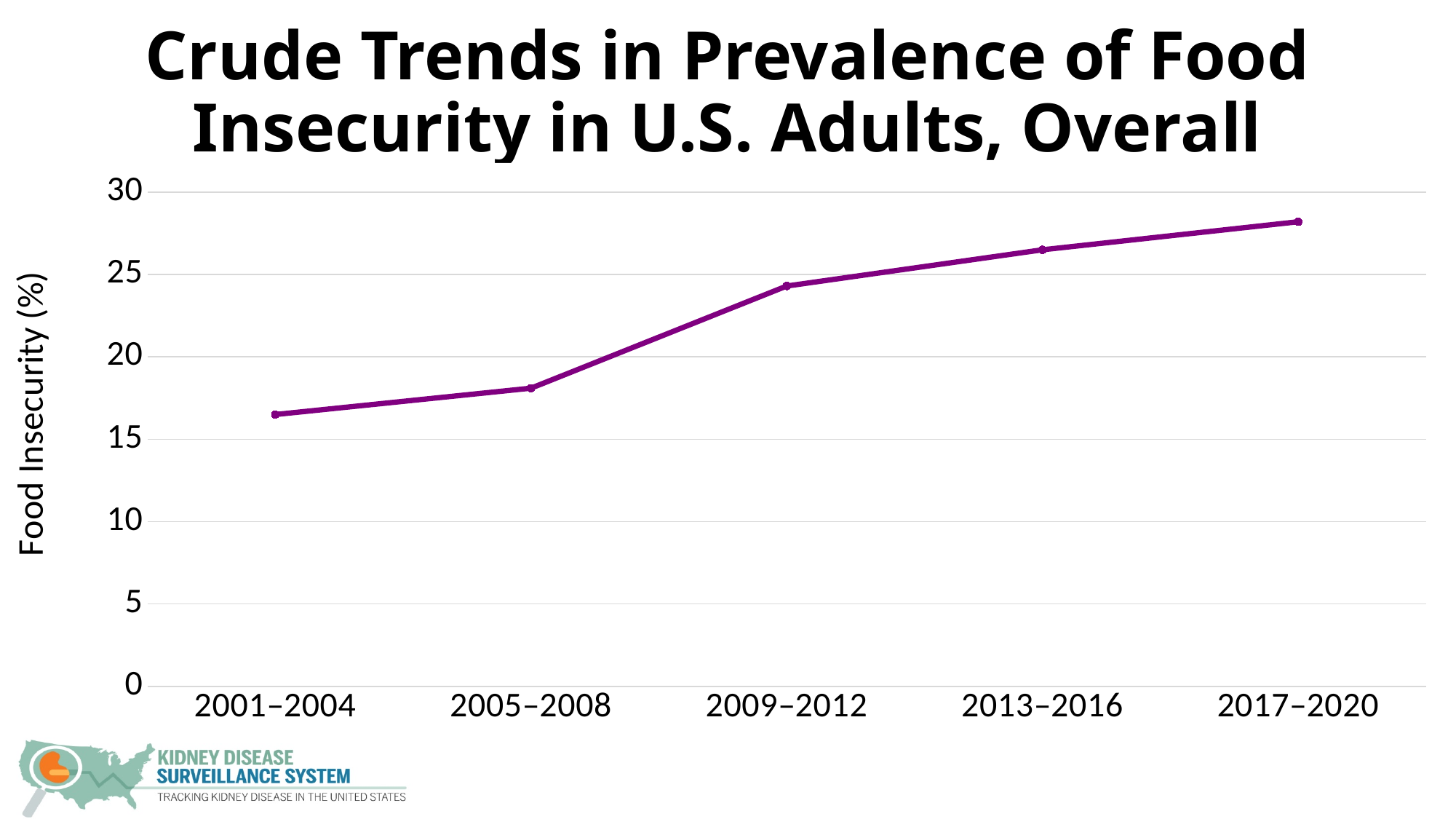
Which period has the lowest food insecurity prevalence? 2001–2004 Which period has the highest food insecurity prevalence? 2017–2020 How many time periods are plotted on the x axis? 5 What is the label of the y axis? Food Insecurity (%) Is the value for 2009–2012 greater or less than 20? greater Is the value for 2017–2020 greater or less than 25? greater What kind of chart is shown on the slide? line chart Which is larger, the value for 2009–2012 or the value for 2005–2008? 2009–2012 Is the value for 2017–2020 greater or less than 30? less Do the values rise or fall from 2001–2004 to 2017–2020? rise